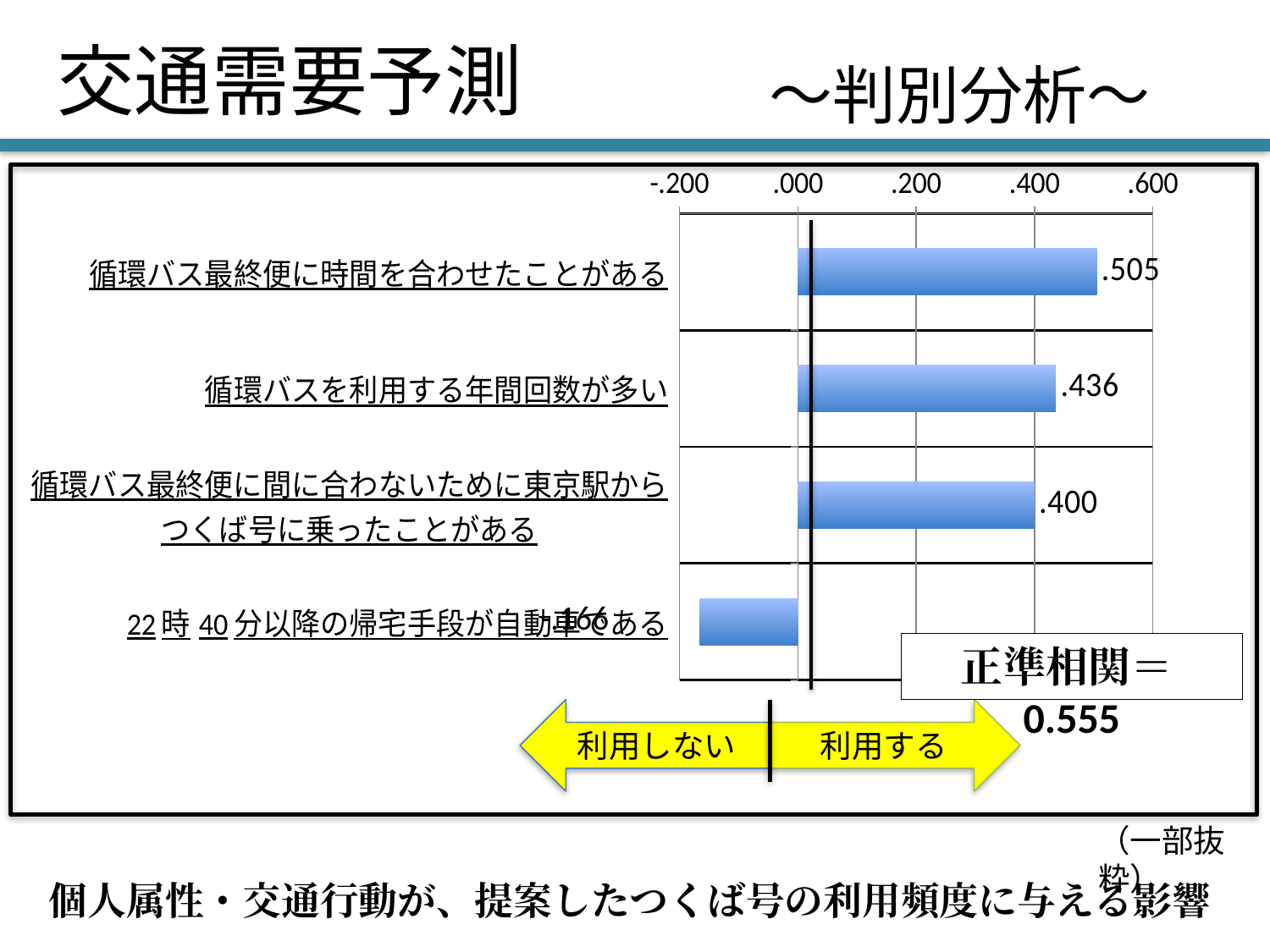
What is the highest tick value shown on the chart's horizontal axis? .600 What is the value for 循環バス最終便に間に合わないために東京駅からつくば号に乗ったことがある? .400 How many categories are shown in the chart? 4 Which is larger: the value for 循環バスを利用する年間回数が多い or the value for 循環バス最終便に間に合わないために東京駅からつくば号に乗ったことがある? 循環バスを利用する年間回数が多い What is the difference between the values for 循環バス最終便に時間を合わせたことがある and 循環バス最終便に間に合わないために東京駅からつくば号に乗ったことがある? .105 Is the value for 22時40分以降の帰宅手段が自動車である greater or less than .000? less What is the value for 循環バスを利用する年間回数が多い? .436 What is the value for 循環バス最終便に時間を合わせたことがある? .505 Which category has the highest value? 循環バス最終便に時間を合わせたことがある What is the difference between the values for 循環バス最終便に時間を合わせたことがある and 循環バスを利用する年間回数が多い? .069 What kind of chart is shown on the slide? bar chart Which category has the lowest value? 22時40分以降の帰宅手段が自動車である